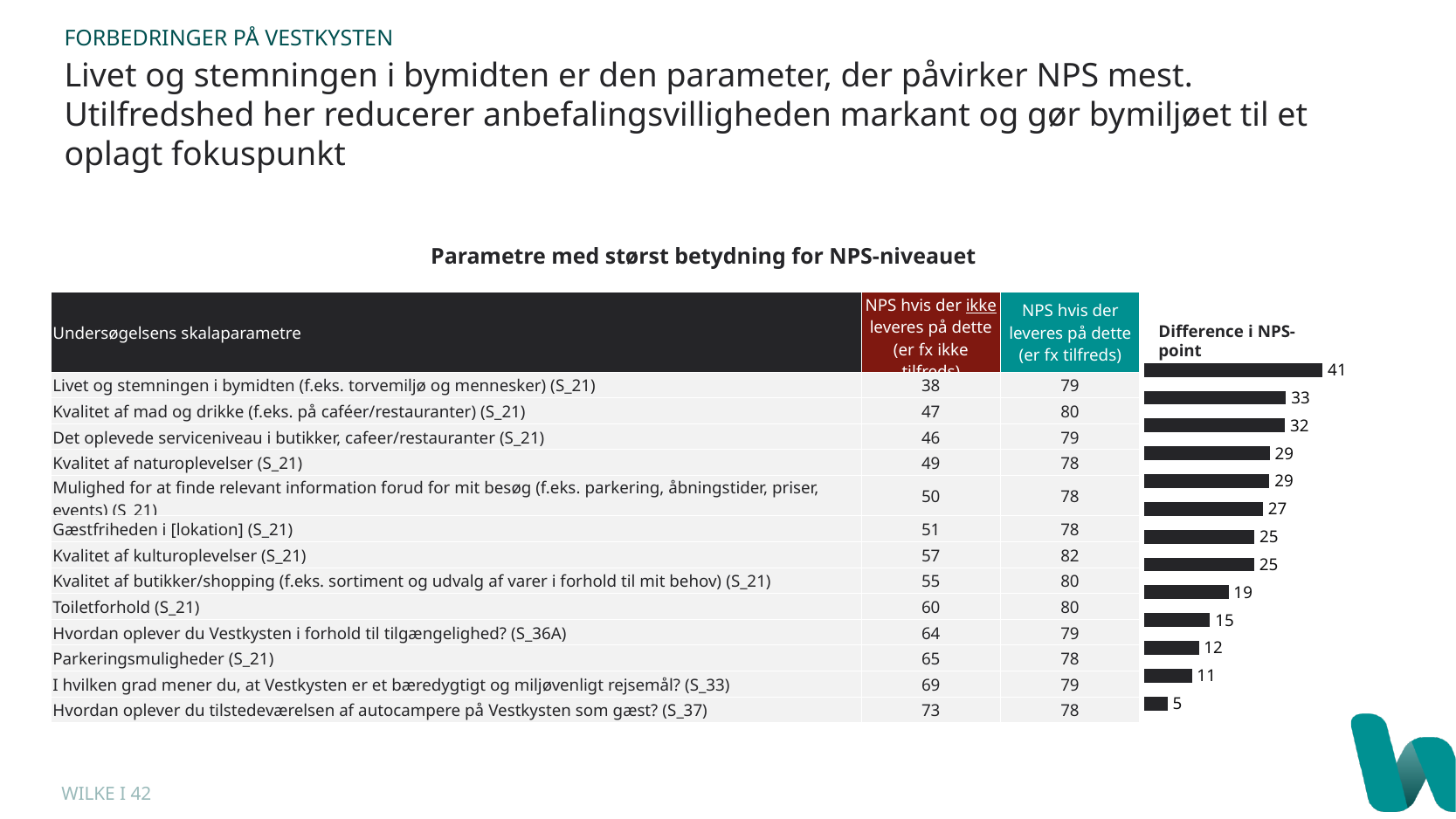
What is the difference between the highest and lowest 'Difference i NPS-point' bars? 36 What is the 'Difference i NPS-point' value for 'Toiletforhold (S_21)'? 19 What is the 'Difference i NPS-point' value for 'Hvordan oplever du Vestkysten i forhold til tilgængelighed? (S_36A)'? 15 What is the title of the chart on the slide? Parametre med størst betydning for NPS-niveauet Do the 'Difference i NPS-point' bars increase or decrease going down the list of parameters? decrease Which parameter has the lowest 'Difference i NPS-point'? Hvordan oplever du tilstedeværelsen af autocampere på Vestkysten som gæst? (S_37) What is the 'Difference i NPS-point' value for 'Parkeringsmuligheder (S_21)'? 12 What is the 'Difference i NPS-point' value for 'Livet og stemningen i bymidten (f.eks. torvemiljø og mennesker) (S_21)'? 41 How many bars are shown in the 'Difference i NPS-point' chart? 13 Which parameter has the highest 'Difference i NPS-point'? Livet og stemningen i bymidten (f.eks. torvemiljø og mennesker) (S_21) Which has a larger 'Difference i NPS-point': 'Kvalitet af mad og drikke (f.eks. på caféer/restauranter) (S_21)' or 'Toiletforhold (S_21)'? Kvalitet af mad og drikke (f.eks. på caféer/restauranter) (S_21) What kind of chart is shown in the 'Difference i NPS-point' column? bar chart